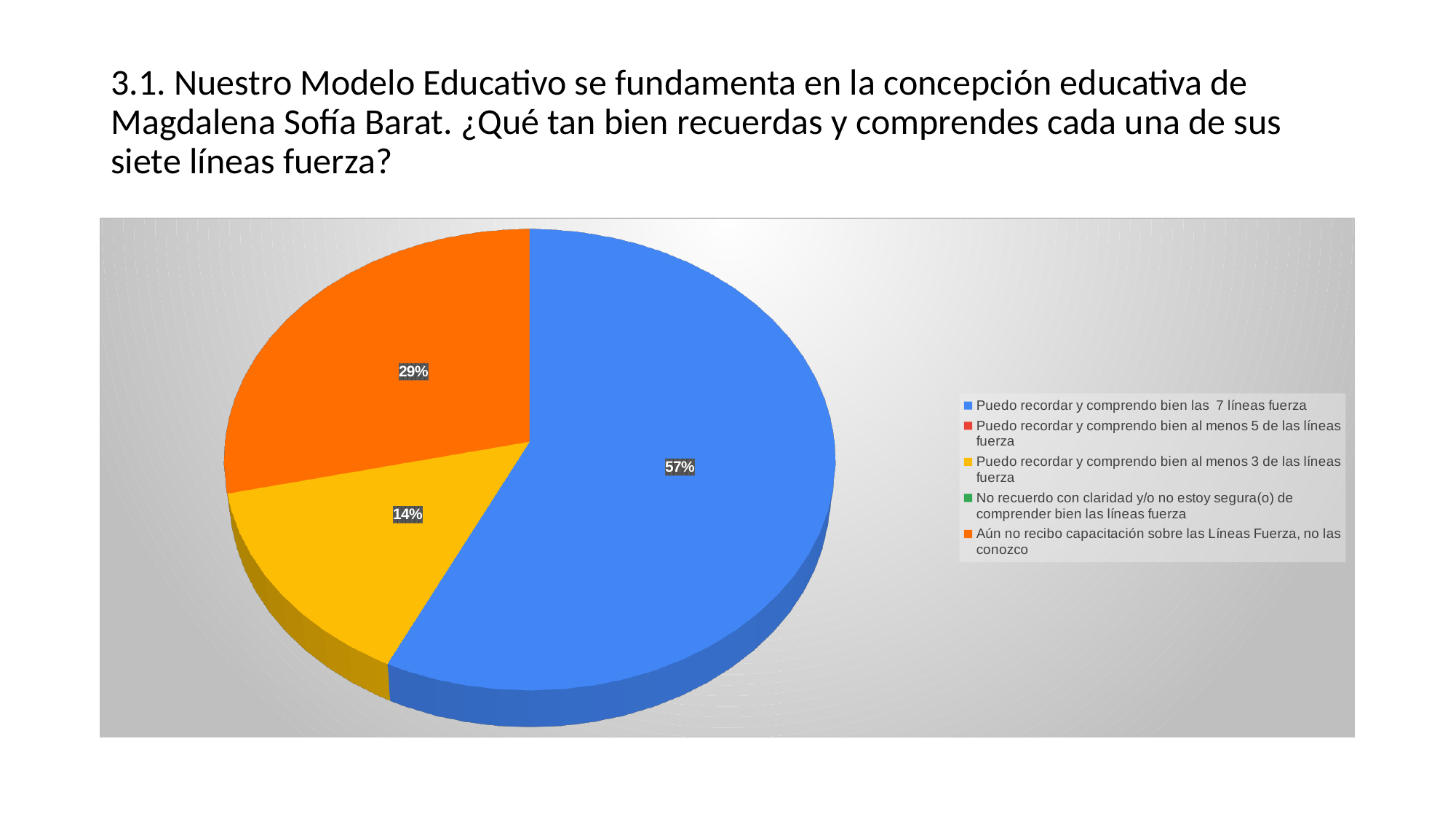
What share of the pie is labelled for "Puedo recordar y comprendo bien las 7 líneas fuerza"? 57% What is the difference in percentage points between the 57% slice and the 29% slice? 28 What share of the pie is labelled for "Puedo recordar y comprendo bien al menos 3 de las líneas fuerza"? 14% How many entries does the legend list? 5 What share of the pie is labelled for "Aún no recibo capacitación sobre las Líneas Fuerza, no las conozco"? 29% Of the slices visible in the pie, which category has the smallest share? Puedo recordar y comprendo bien al menos 3 de las líneas fuerza What kind of chart is shown on the slide? Pie chart Which legend category has the largest slice of the pie? Puedo recordar y comprendo bien las 7 líneas fuerza How many slices with a percentage label are visible in the pie? 3 Which is larger: the share for "Aún no recibo capacitación sobre las Líneas Fuerza, no las conozco" or the share for "Puedo recordar y comprendo bien al menos 3 de las líneas fuerza"? Aún no recibo capacitación sobre las Líneas Fuerza, no las conozco What colour is the slice labelled 57%? Blue What is the difference in percentage points between the 29% slice and the 14% slice? 15